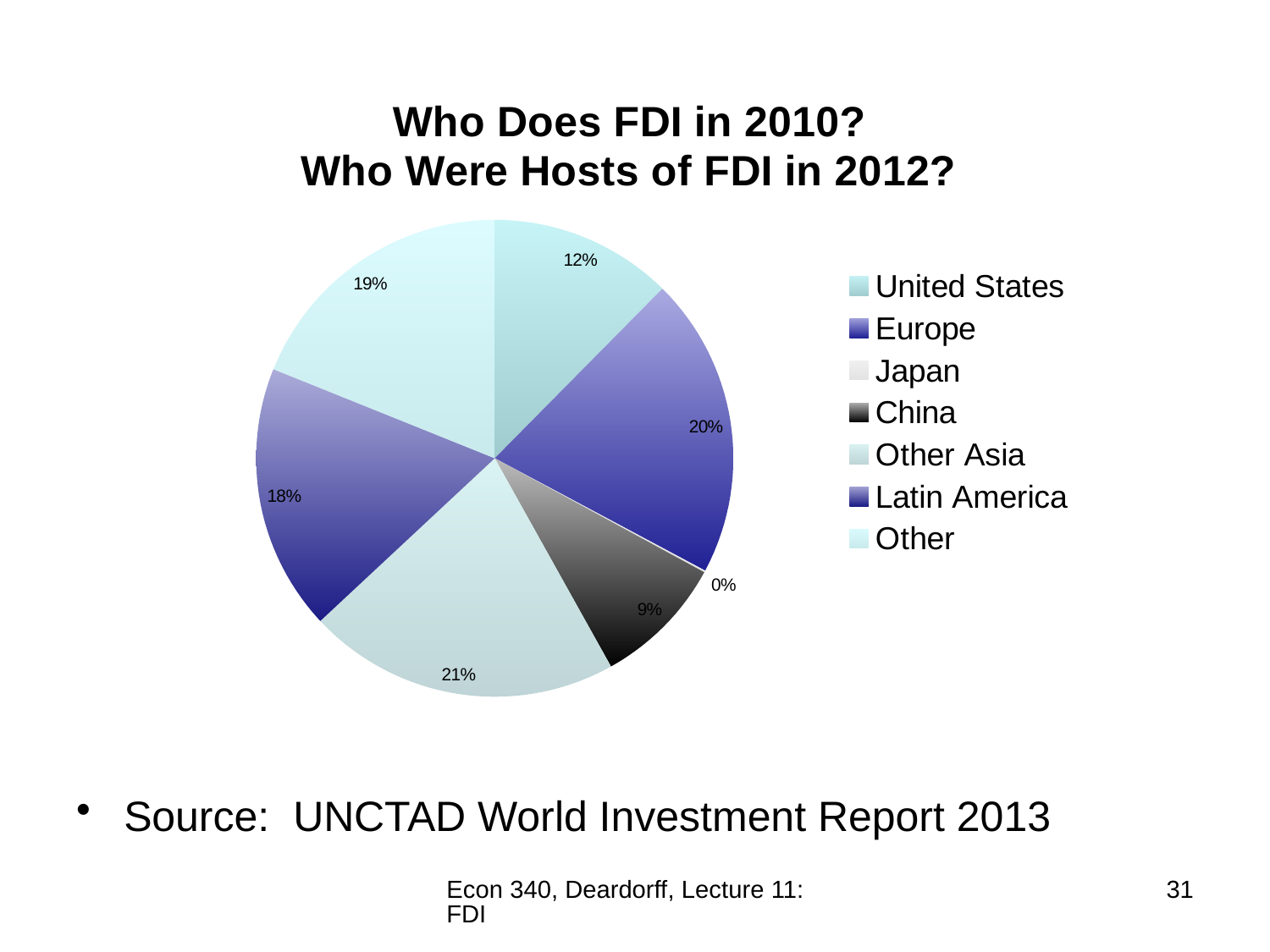
How many categories does the legend list? 7 Which slice is larger, Latin America or Other? Other Which category has the largest slice of the pie? Other Asia What share of the pie does Other Asia hold? 21% What is the difference in percentage points between the Other Asia slice and the China slice? 12 What kind of chart is shown on the slide? Pie chart What share of the pie does the United States hold? 12% What share of the pie does Europe hold? 20% What share of the pie does China hold? 9% What share of the pie does Japan hold? 0% Which category has the smallest slice of the pie? Japan What share of the pie does Latin America hold? 18%